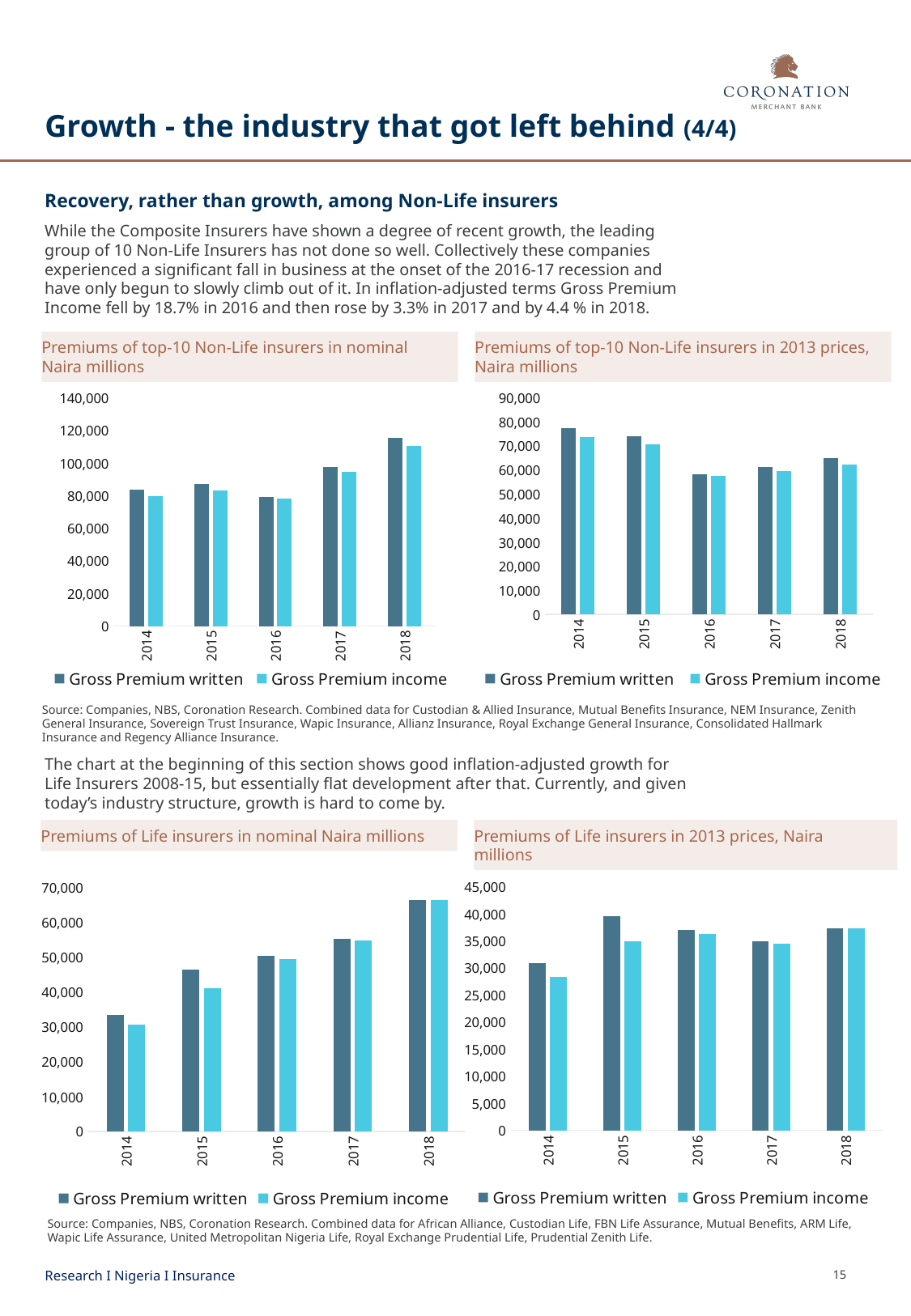
What type of chart is the chart titled 'Premiums of Life insurers in 2013 prices, Naira millions'? bar chart In the chart titled 'Premiums of top-10 Non-Life insurers in 2013 prices, Naira millions', which is larger: Gross Premium written in 2014 or in 2018? 2014 In the chart titled 'Premiums of Life insurers in nominal Naira millions', do the Gross Premium written values rise or fall from 2014 to 2018? rise In the chart titled 'Premiums of top-10 Non-Life insurers in 2013 prices, Naira millions', is the Gross Premium income for 2016 greater or less than 60,000? less In the chart titled 'Premiums of top-10 Non-Life insurers in nominal Naira millions', which year has the highest Gross Premium written? 2018 In the chart titled 'Premiums of top-10 Non-Life insurers in nominal Naira millions', how many series does the legend list? 2 In the chart titled 'Premiums of Life insurers in nominal Naira millions', is the Gross Premium written for 2018 greater or less than 60,000? greater In the chart titled 'Premiums of top-10 Non-Life insurers in 2013 prices, Naira millions', which year has the highest Gross Premium written? 2014 In the chart titled 'Premiums of Life insurers in 2013 prices, Naira millions', how many years are shown on the x axis? 5 In the chart titled 'Premiums of Life insurers in 2013 prices, Naira millions', which year has the highest Gross Premium written? 2015 In the chart titled 'Premiums of Life insurers in nominal Naira millions', which year has the lowest Gross Premium income? 2014 In the chart titled 'Premiums of top-10 Non-Life insurers in nominal Naira millions', is the Gross Premium written for 2018 greater or less than 100,000? greater